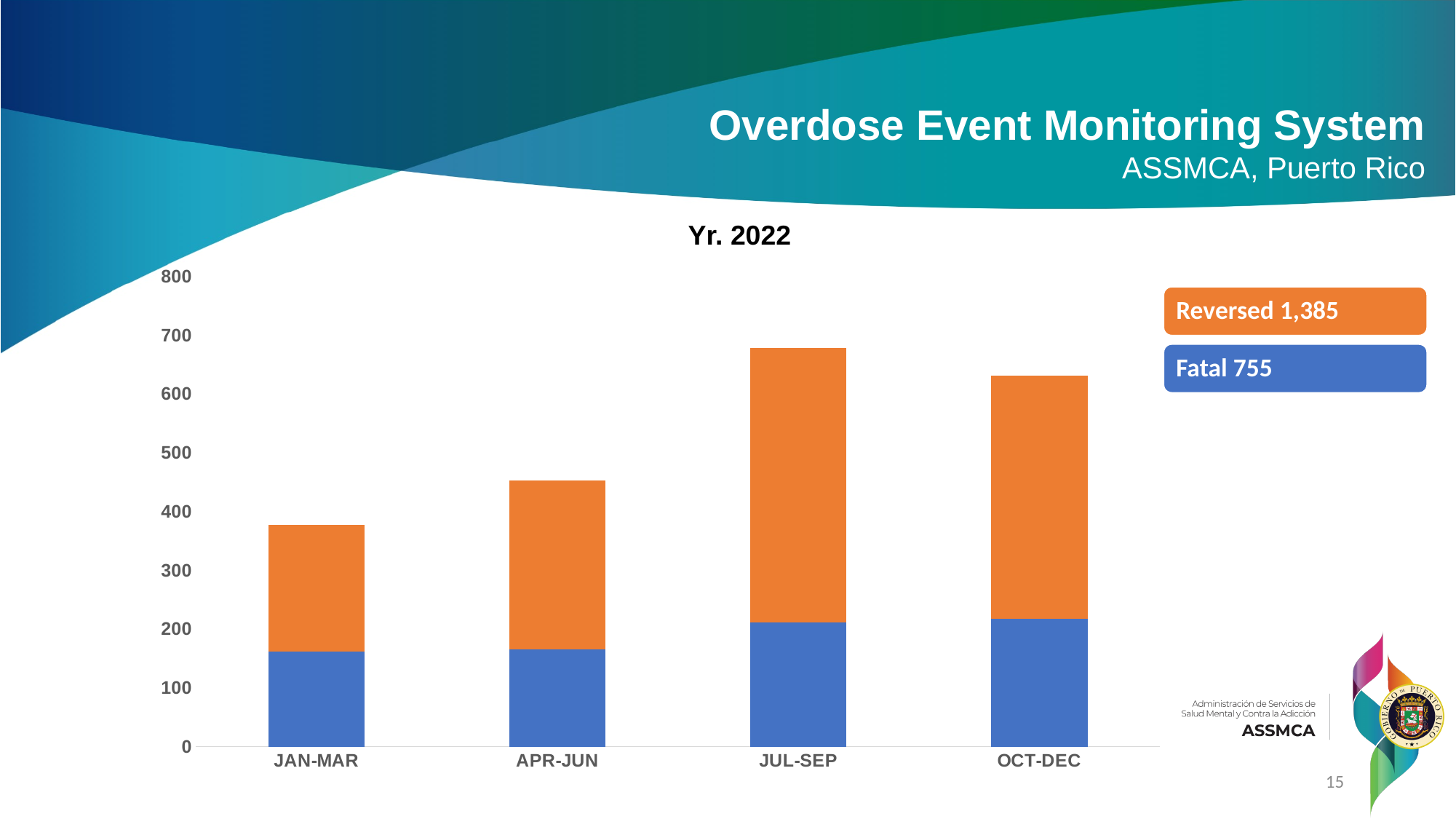
Is the total bar for JAN-MAR greater or less than 400? less Which quarter has the larger total bar, JUL-SEP or OCT-DEC? JUL-SEP How many quarters (categories) are plotted on the x axis? 4 What total is shown in the legend for the Reversed series? 1,385 Do the total bars rise or fall from JAN-MAR to JUL-SEP? rise Which quarter has the lowest total bar? JAN-MAR Is the total bar for JUL-SEP greater or less than 600? greater Which quarter has the highest total bar? JUL-SEP What kind of chart is shown on the slide? Stacked bar chart Is the total bar for OCT-DEC greater or less than 700? less How many series does the legend list? 2